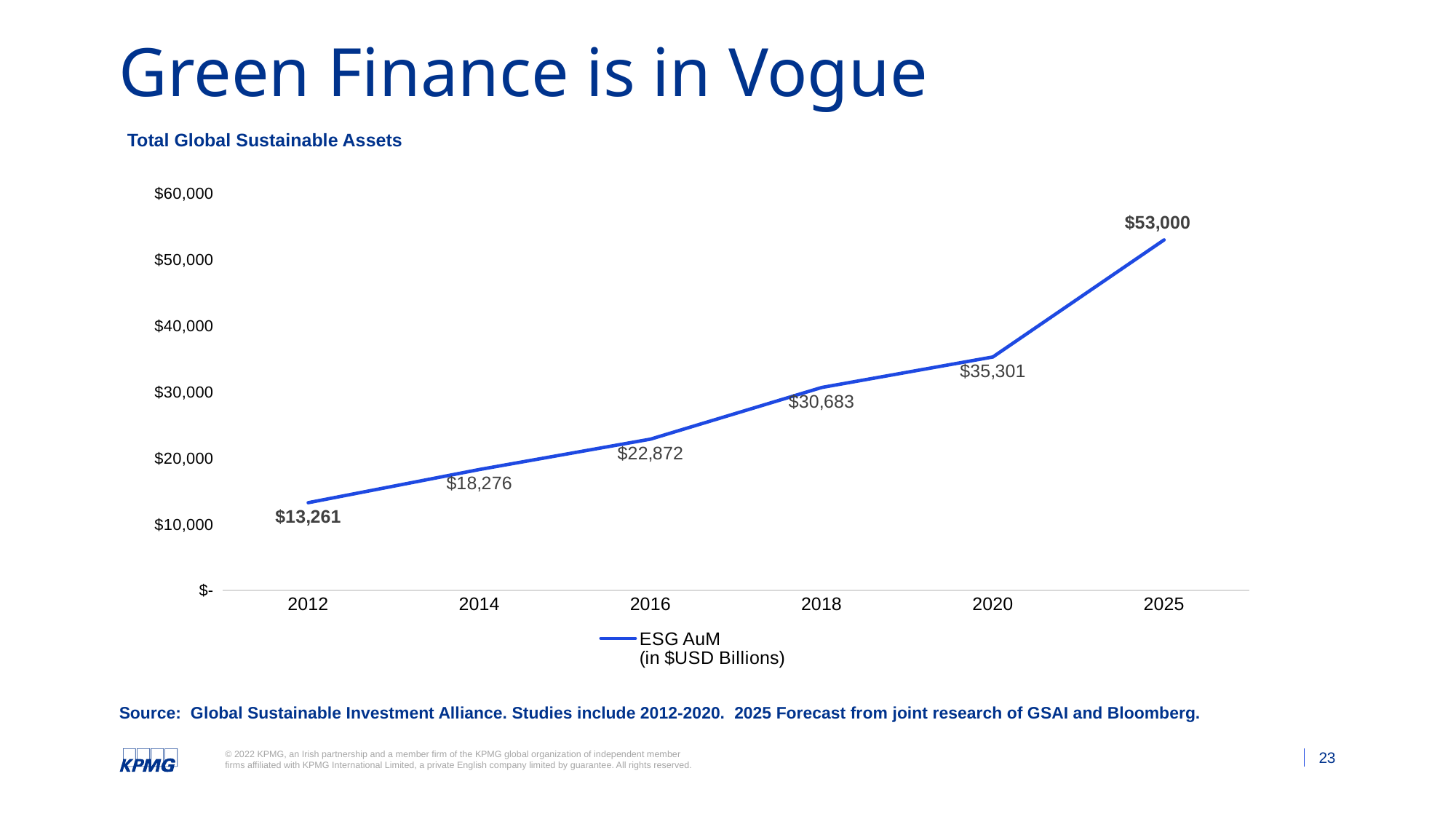
Which is larger, the ESG AuM value for 2016 or for 2018? 2018 What is the difference between the ESG AuM values for 2018 and 2014? $12,407 What is the ESG AuM value for 2012? $13,261 What is the forecast ESG AuM value for 2025? $53,000 Which year has the highest ESG AuM value? 2025 How many years are plotted on the x axis? 6 Do the ESG AuM values rise or fall from 2012 to 2025? rise What is the ESG AuM value for 2020? $35,301 What is the ESG AuM value for 2016? $22,872 Is the ESG AuM value for 2020 greater or less than $40,000? less What kind of chart is shown on the slide? line chart Which year has the lowest ESG AuM value? 2012